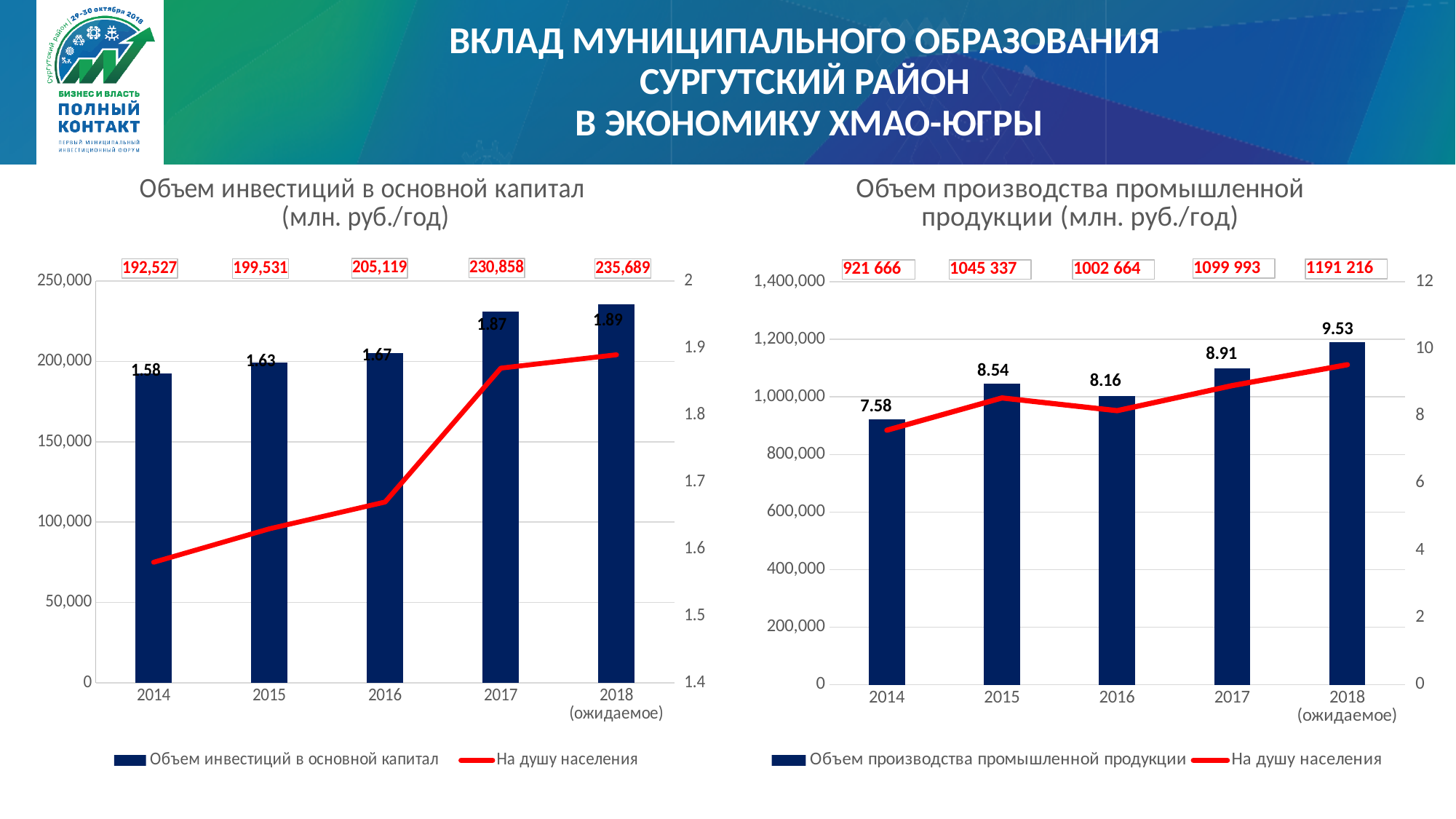
In the chart 'Объем инвестиций в основной капитал (млн. руб./год)', what is the difference between the bar values for 2017 and 2016? 25,739 In the chart 'Объем инвестиций в основной капитал (млн. руб./год)', what is the value of the bar for 2014? 192,527 In the chart 'Объем инвестиций в основной капитал (млн. руб./год)', how many series does the legend list? 2 In the chart 'Объем инвестиций в основной капитал (млн. руб./год)', which year has the highest bar value? 2018 (ожидаемое) In the chart 'Объем производства промышленной продукции (млн. руб./год)', what is the 'На душу населения' value for 2018 (ожидаемое)? 9.53 In the chart 'Объем производства промышленной продукции (млн. руб./год)', which year has the lowest bar value? 2014 In the chart 'Объем инвестиций в основной капитал (млн. руб./год)', what is the 'На душу населения' value for 2017? 1.87 In the chart 'Объем производства промышленной продукции (млн. руб./год)', how many years are shown on the x axis? 5 In the chart 'Объем инвестиций в основной капитал (млн. руб./год)', does the 'На душу населения' line rise or fall from 2014 to 2018? rise What type of chart is 'Объем производства промышленной продукции (млн. руб./год)'? Combined bar and line chart In the chart 'Объем производства промышленной продукции (млн. руб./год)', what is the bar value for 2015? 1045 337 In the chart 'Объем производства промышленной продукции (млн. руб./год)', which is larger, the bar value for 2015 or for 2016? 2015